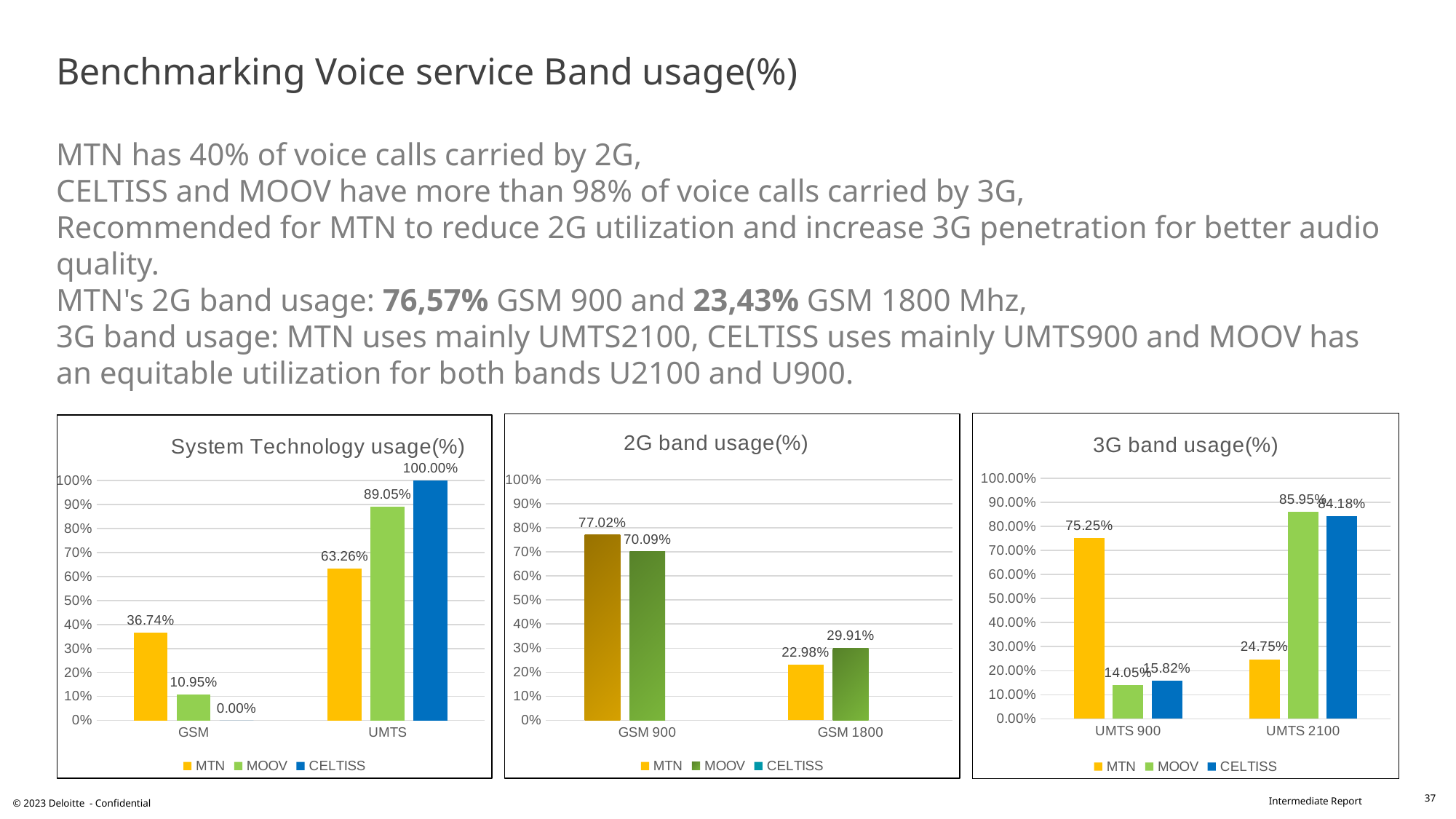
In the System Technology usage(%) chart, what is the value for CELTISS in the UMTS category? 100.00% In the 3G band usage(%) chart, which series has the highest value in the UMTS 2100 category? MOOV In the System Technology usage(%) chart, which series has the lowest value in the GSM category? CELTISS In the 2G band usage(%) chart, which is larger in the GSM 1800 category, MTN or MOOV? MOOV In the System Technology usage(%) chart, what is the difference between MOOV's UMTS value and MTN's UMTS value? 25.79% How many series does the legend of the 3G band usage(%) chart list? 3 What type of chart is the 2G band usage(%) chart? Bar chart In the 3G band usage(%) chart, is the value for CELTISS in UMTS 900 greater or less than 20.00%? less In the 2G band usage(%) chart, what is the difference between MTN's GSM 900 value and MOOV's GSM 900 value? 6.93% In the System Technology usage(%) chart, what is the value for MTN in the GSM category? 36.74% In the 3G band usage(%) chart, what is the value for MTN in the UMTS 900 category? 75.25% In the 2G band usage(%) chart, what is the value for MOOV in the GSM 900 category? 70.09%